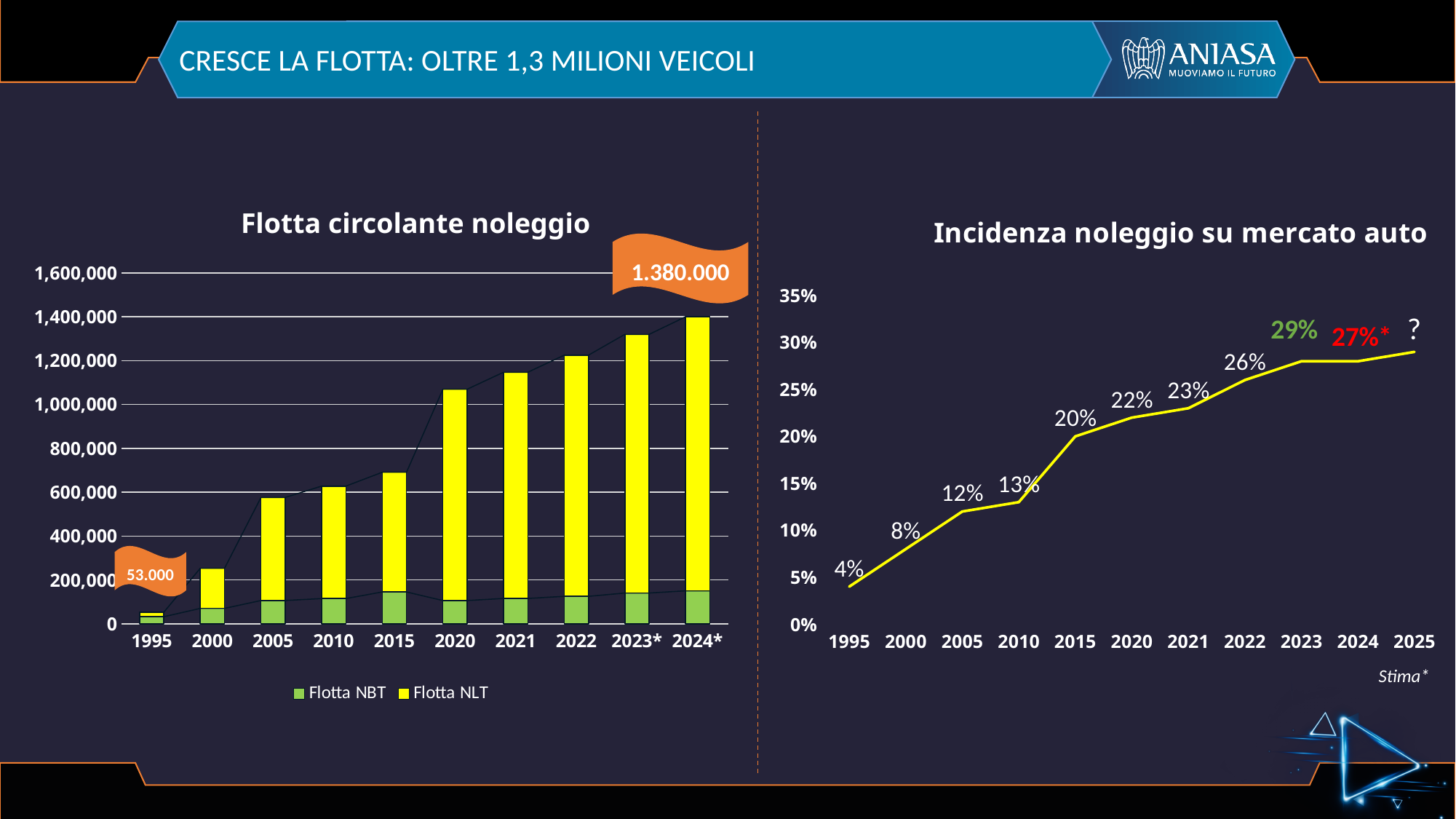
In the chart 'Incidenza noleggio su mercato auto', what is the value for 2015? 20% In the chart 'Flotta circolante noleggio', what total fleet value is shown in the callout for 2024*? 1.380.000 In the chart 'Flotta circolante noleggio', is the total bar for 2015 greater or less than 800,000? less In the chart 'Incidenza noleggio su mercato auto', what is the difference between the 2023 value and the 2024 value? 2% In the chart 'Incidenza noleggio su mercato auto', which is larger, the value for 2005 or the value for 2010? 2010 How many series does the legend of the chart 'Flotta circolante noleggio' list? 2 In the chart 'Incidenza noleggio su mercato auto', what is the value for 2023? 29% What kind of chart is 'Incidenza noleggio su mercato auto'? Line chart In the chart 'Incidenza noleggio su mercato auto', which year has the lowest value? 1995 In the chart 'Incidenza noleggio su mercato auto', what is the value shown for 2024? 27%* What kind of chart is 'Flotta circolante noleggio'? Stacked bar chart